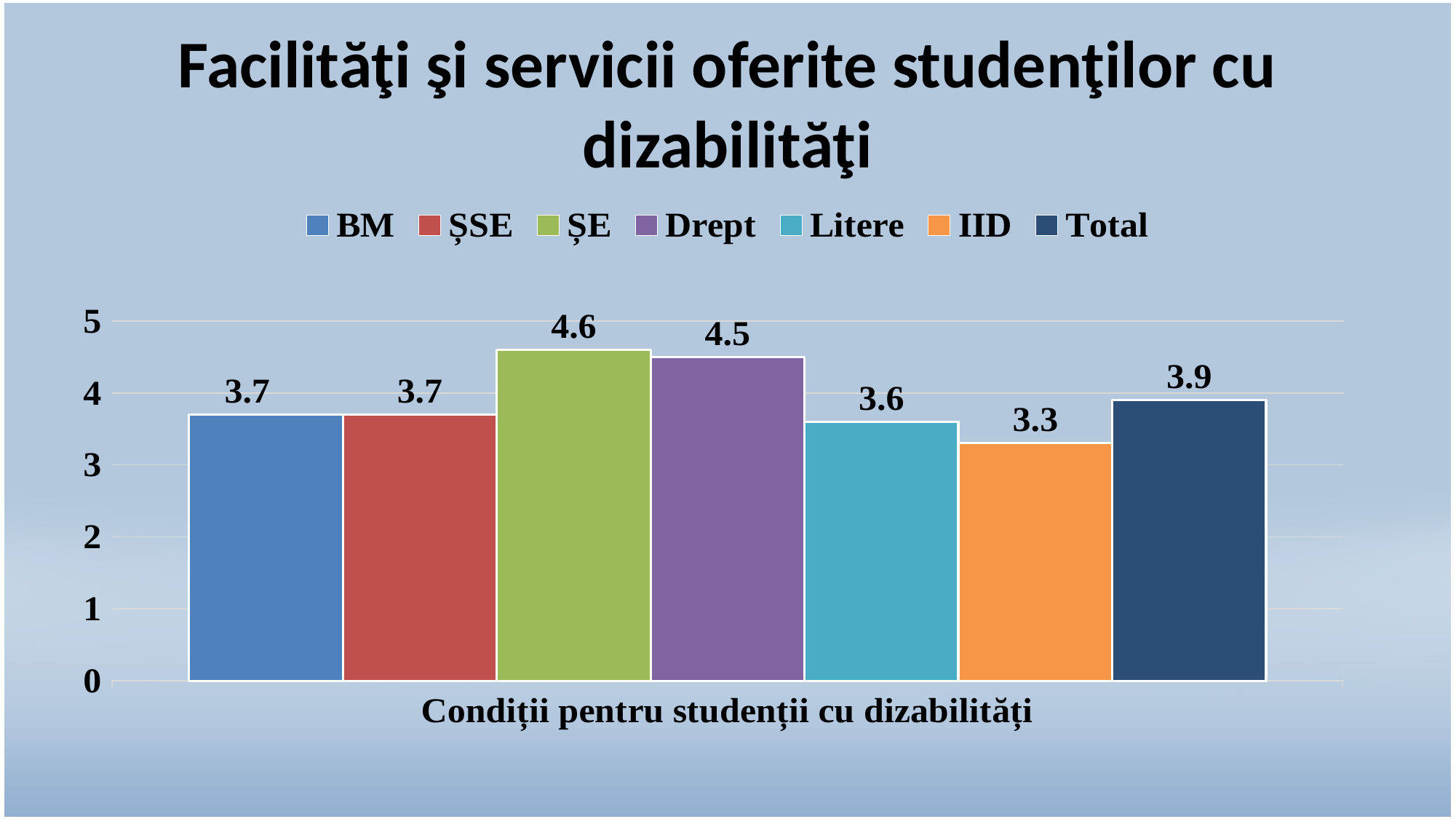
Which series has the lowest value? IID What is the value for Total? 3.9 How many series does the legend list? 7 Which is larger, the value for Drept or the value for Total? Drept What is the difference between the values for ȘE and IID? 1.3 Is the value for Drept greater or less than 4? greater What is the value for Litere? 3.6 What is the value for ȘE? 4.6 What kind of chart is shown on the slide? bar chart What is the label on the x axis of the chart? Condiții pentru studenții cu dizabilități What is the value for IID? 3.3 Which series has the highest value? ȘE